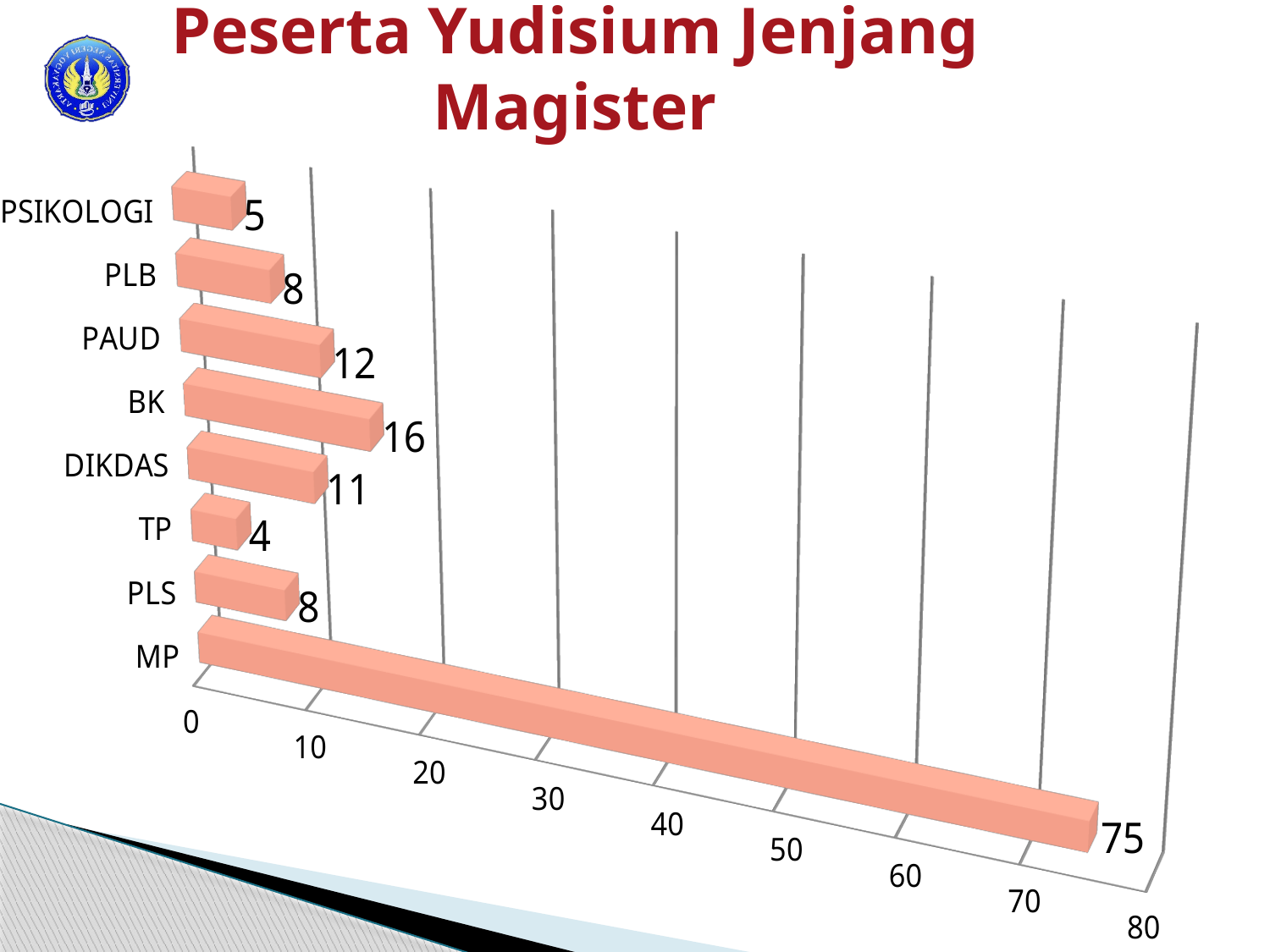
Which category has the highest value? MP What is the value for MP? 75 What kind of chart is shown on the slide? Bar chart Which category has the lowest value? TP Which is larger, the value for PAUD or the value for DIKDAS? PAUD What is the title of the chart? Peserta Yudisium Jenjang Magister How many categories are shown in the chart? 8 What is the value for BK? 16 What is the difference between the values for DIKDAS and PSIKOLOGI? 6 What is the value for TP? 4 What is the value for PAUD? 12 What is the difference between the values for MP and BK? 59